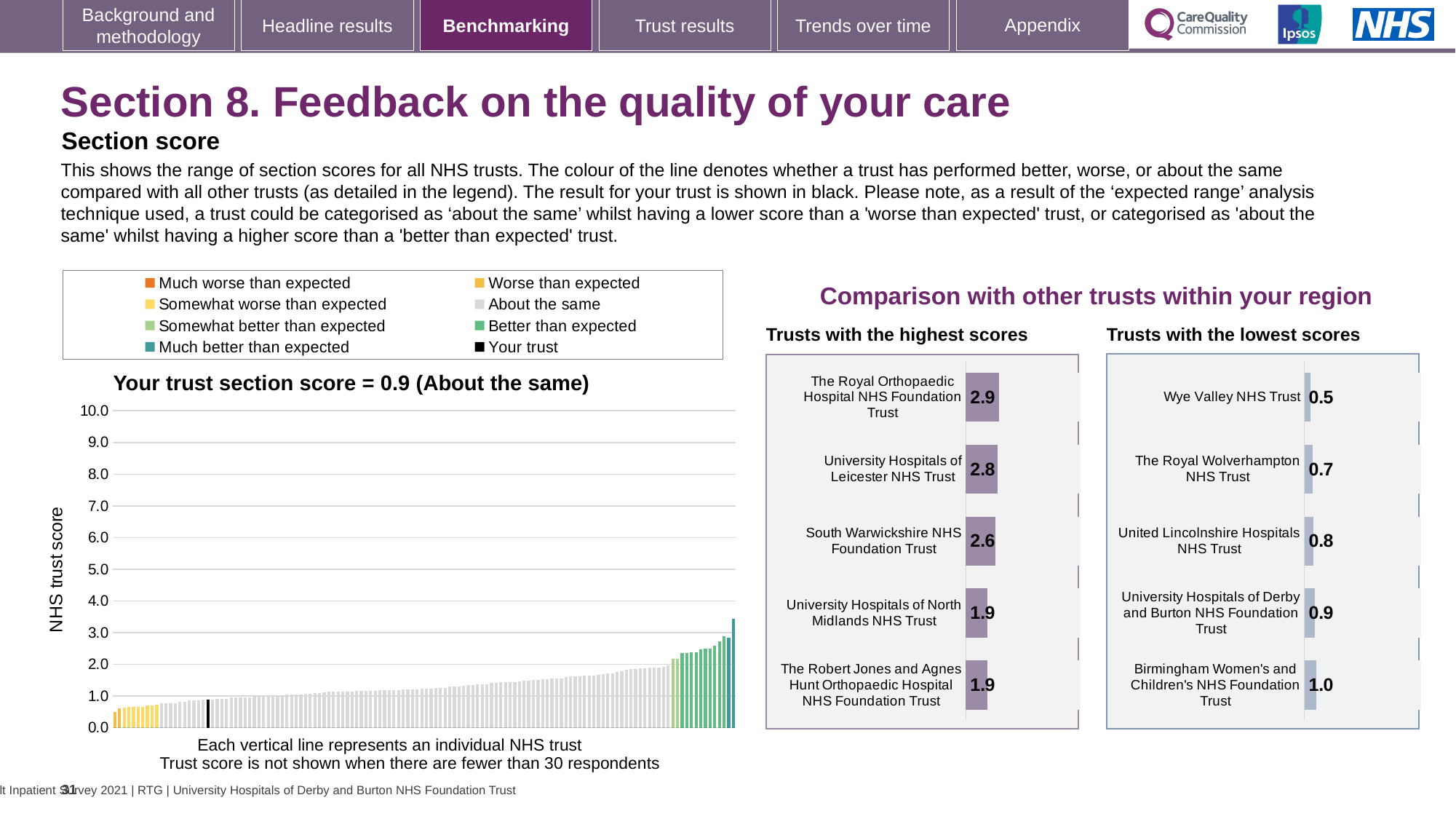
In the 'Your trust section score' chart, do the trust scores rise or fall from left to right along the x axis? Rise In the 'Trusts with the lowest scores' chart, what is the difference between the scores of Birmingham Women's and Children's NHS Foundation Trust and Wye Valley NHS Trust? 0.5 What kind of chart is the 'Your trust section score' chart? Bar chart In the 'Trusts with the lowest scores' chart, which trust has the lowest score? Wye Valley NHS Trust In the 'Trusts with the highest scores' chart, which trust has the highest score? The Royal Orthopaedic Hospital NHS Foundation Trust In the 'Trusts with the highest scores' chart, what is the score for The Royal Orthopaedic Hospital NHS Foundation Trust? 2.9 In the 'Trusts with the lowest scores' chart, what is the score for Wye Valley NHS Trust? 0.5 In the 'Your trust section score' chart, what is the section score for your trust? 0.9 In the 'Trusts with the highest scores' chart, what is the score for South Warwickshire NHS Foundation Trust? 2.6 In the 'Trusts with the highest scores' chart, what is the difference between the scores of University Hospitals of Leicester NHS Trust and University Hospitals of North Midlands NHS Trust? 0.9 In the 'Trusts with the lowest scores' chart, which has the larger score: The Royal Wolverhampton NHS Trust or Birmingham Women's and Children's NHS Foundation Trust? Birmingham Women's and Children's NHS Foundation Trust In the 'Trusts with the highest scores' chart, how many trusts are shown? 5